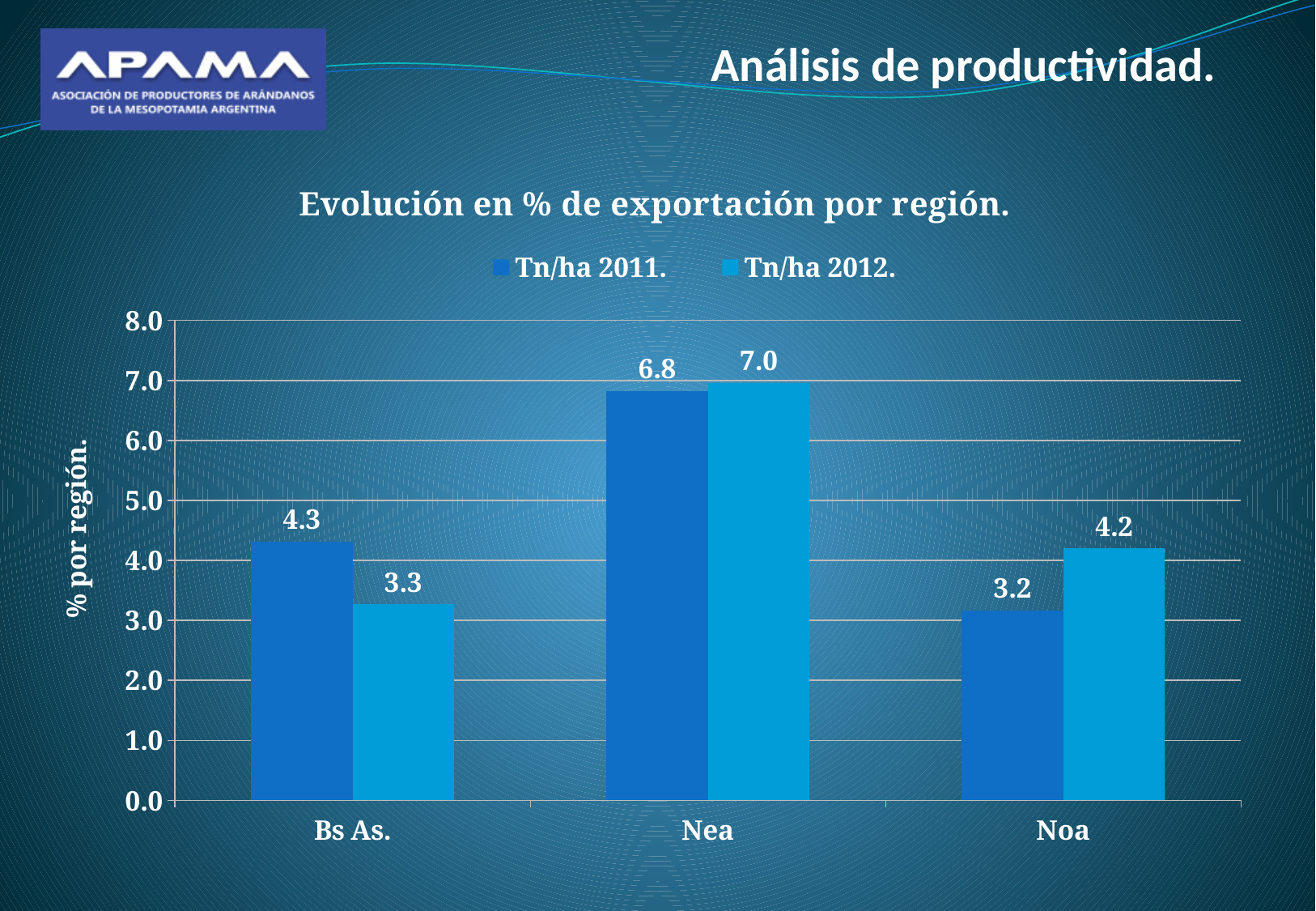
What is the Tn/ha 2012. value for Noa? 4.2 Which is larger for Noa, the Tn/ha 2011. value or the Tn/ha 2012. value? Tn/ha 2012. What is the difference between the Tn/ha 2011. and Tn/ha 2012. values for Bs As.? 1.0 What is the Tn/ha 2011. value for Nea? 6.8 How many series does the legend list? 2 What is the Tn/ha 2012. value for Bs As.? 3.3 What kind of chart is shown on the slide? Bar chart Which region has the lowest Tn/ha 2011. value? Noa What is the title of the chart? Evolución en % de exportación por región. Which region has the highest Tn/ha 2012. value? Nea How many regions are shown on the x axis? 3 What is the difference between the Tn/ha 2012. values for Nea and Noa? 2.8